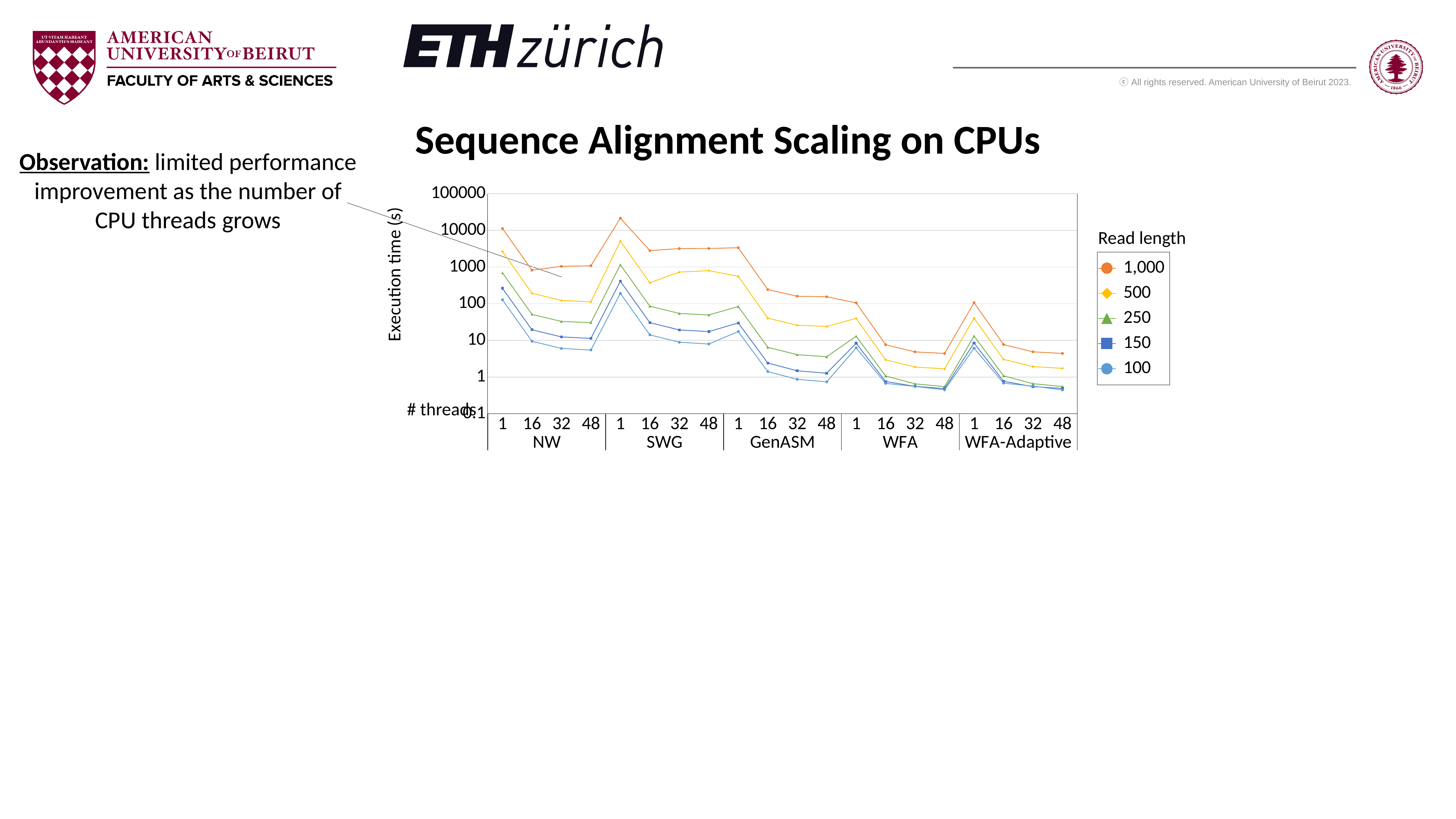
How many alignment algorithms are shown along the x axis? 5 Which algorithm has the highest execution time at 1 thread for read length 1,000? SWG What is the title of the chart? Sequence Alignment Scaling on CPUs Is the execution time for read length 1,000 at 1 thread for GenASM greater or less than 1000? greater Is the execution time for read length 100 at 48 threads for NW greater or less than 10? less How many series does the legend list? 5 Which read length series has the lowest execution times across the chart? 100 Which thread counts are shown for each algorithm on the x axis? 1, 16, 32, 48 Within each algorithm, does execution time rise or fall as the number of threads increases from 1 to 48? fall What is the label of the y axis? Execution time (s) Is the execution time for read length 1,000 at 1 thread for SWG greater or less than 10000? greater What kind of chart is shown on the slide? Line chart